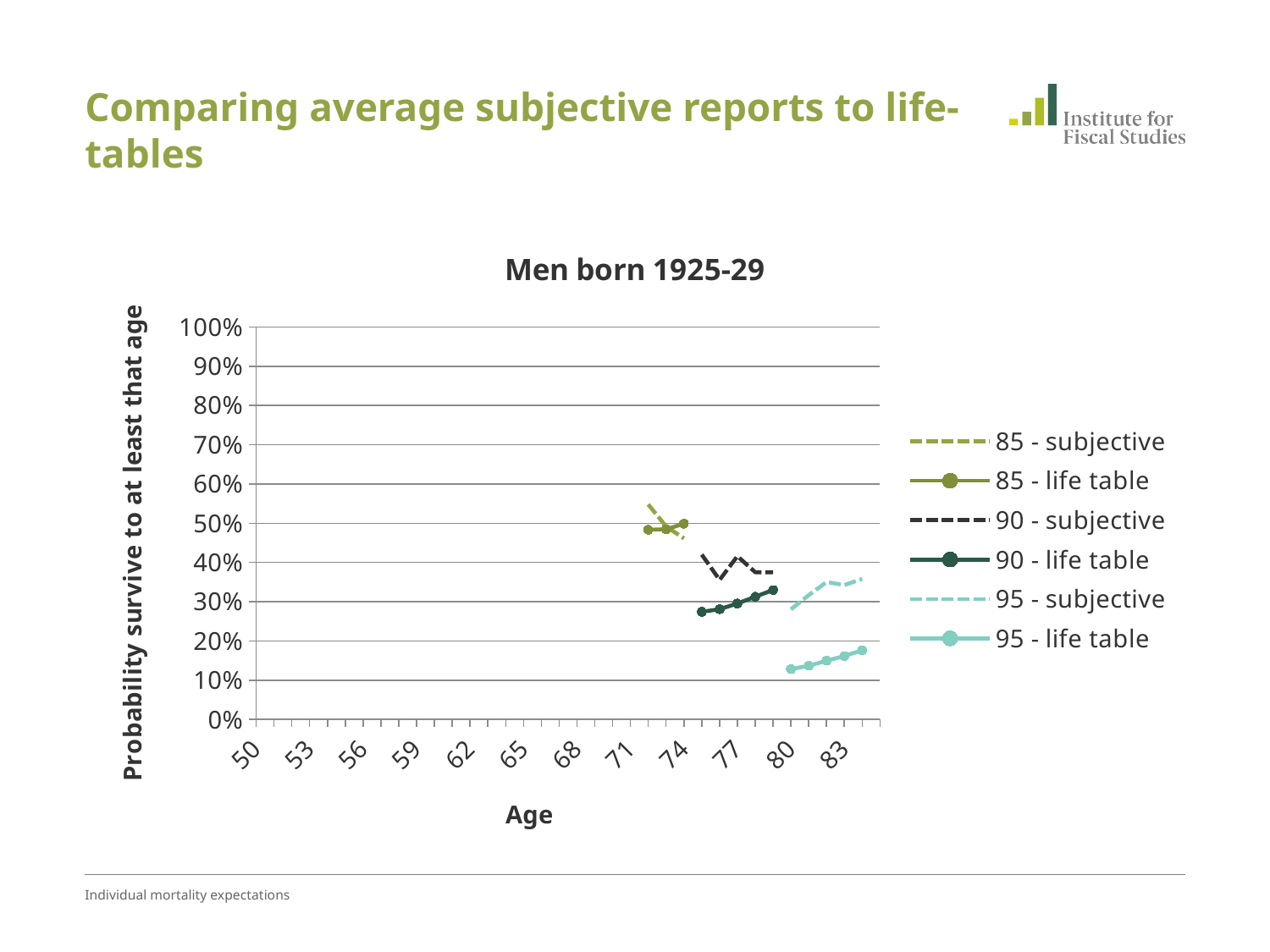
Do the values of the '95 - life table' series rise or fall as age increases? rise How many series does the legend list? 6 What is the title of the chart? Men born 1925-29 Which series has the lowest values on the chart? 95 - life table What is the label on the vertical axis? Probability survive to at least that age Are the values for the '95 - subjective' series greater or less than 40%? less Are the values for the '85 - life table' series greater or less than 40%? greater What kind of chart is shown on the slide? line chart Which series has higher values, '85 - life table' or '95 - life table'? 85 - life table Are the values for the '90 - life table' series greater or less than 40%? less Do the values of the '90 - life table' series rise or fall as age increases? rise